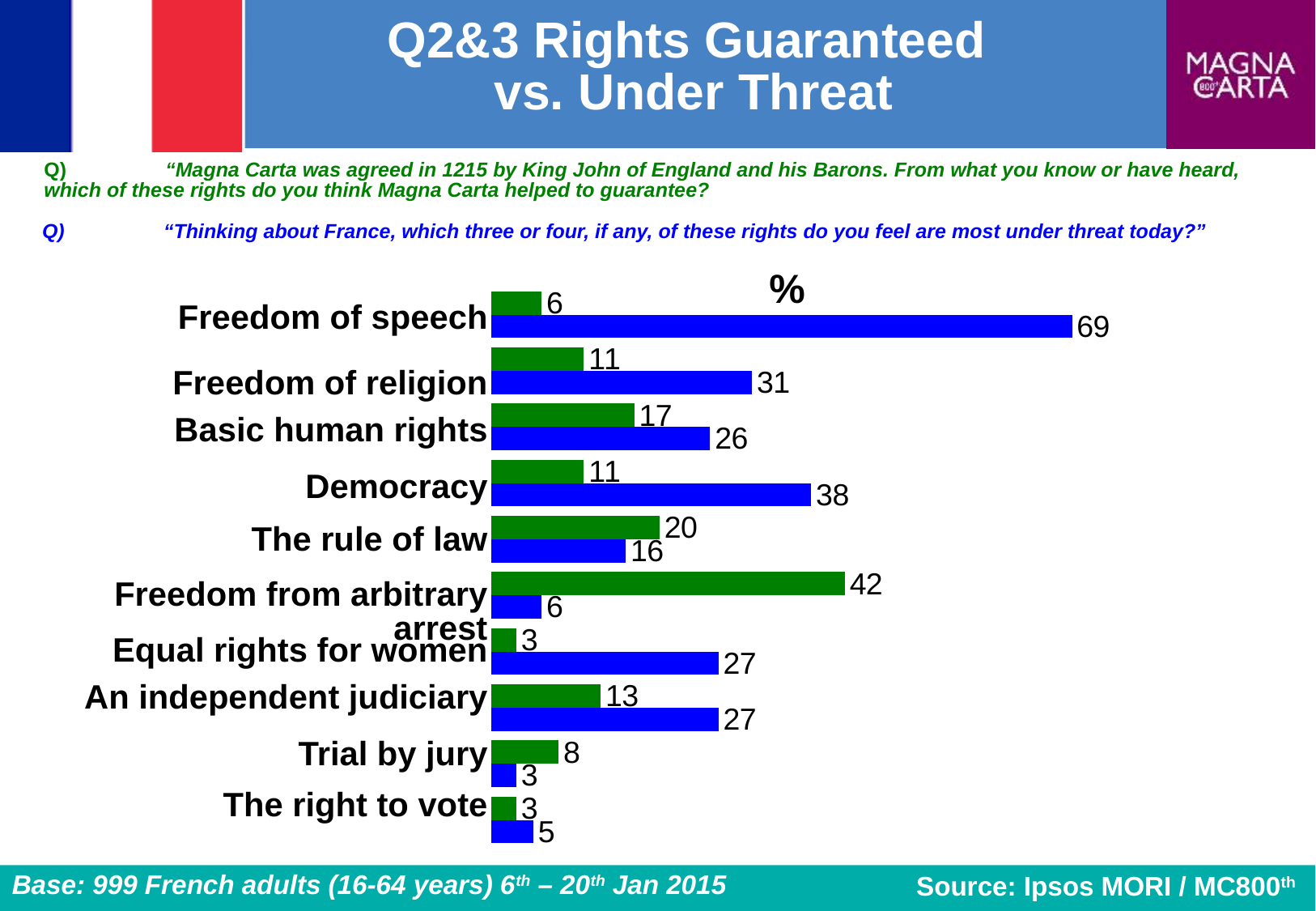
What is the difference between the green and blue bar values for The rule of law? 4 What is the value of the blue bar for Freedom of speech? 69 What kind of chart is shown on the slide? bar chart What is the value of the blue bar for Democracy? 38 Which category has the highest green bar value? Freedom from arbitrary arrest Which category has the lowest blue bar value? Trial by jury What is the value of the green bar for The rule of law? 20 Which category has the highest blue bar value? Freedom of speech How many categories are shown on the chart? 10 Which is larger for Basic human rights, the green bar or the blue bar? the blue bar What is the difference between the blue bar values for Freedom of speech and Freedom of religion? 38 What is the value of the green bar for Freedom from arbitrary arrest? 42